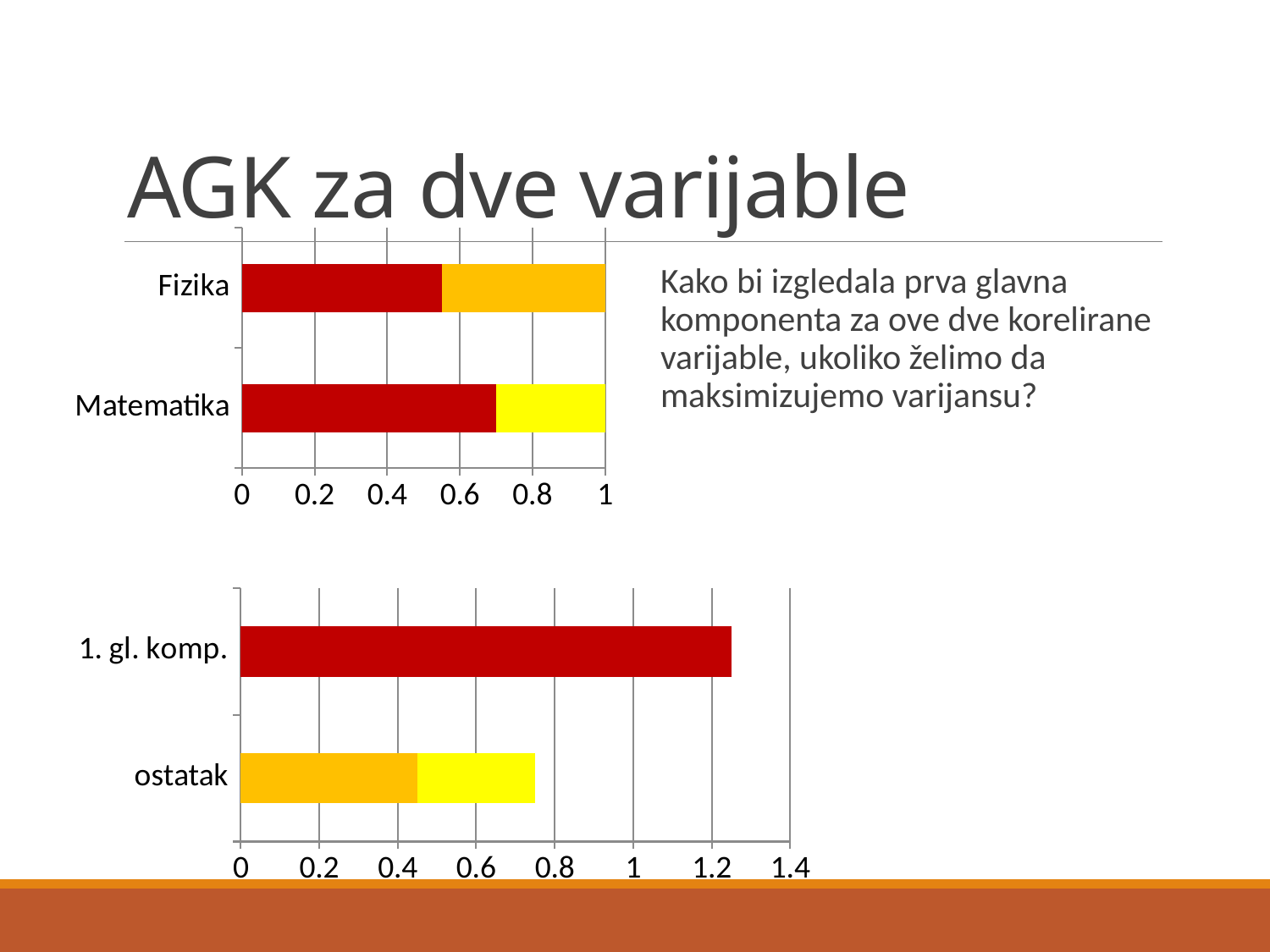
In the bottom chart, is the value for 1. gl. komp. greater or less than 1? greater In the top chart, what is the total length of the stacked bar for Fizika? 1 In the top chart, what is the total length of the stacked bar for Matematika? 1 What kind of chart is the bottom chart on the slide? bar chart In the bottom chart, is the total bar length for ostatak greater or less than 0.8? less What kind of chart is the top chart on the slide? bar chart In the bottom chart, how many categories are shown on the vertical axis? 2 In the top chart, is the red segment for Fizika greater or less than 0.4? greater In the bottom chart, which category has the longest bar? 1. gl. komp. In the top chart, how many categories are shown on the vertical axis? 2 In the top chart, which category has the longer red segment, Fizika or Matematika? Matematika